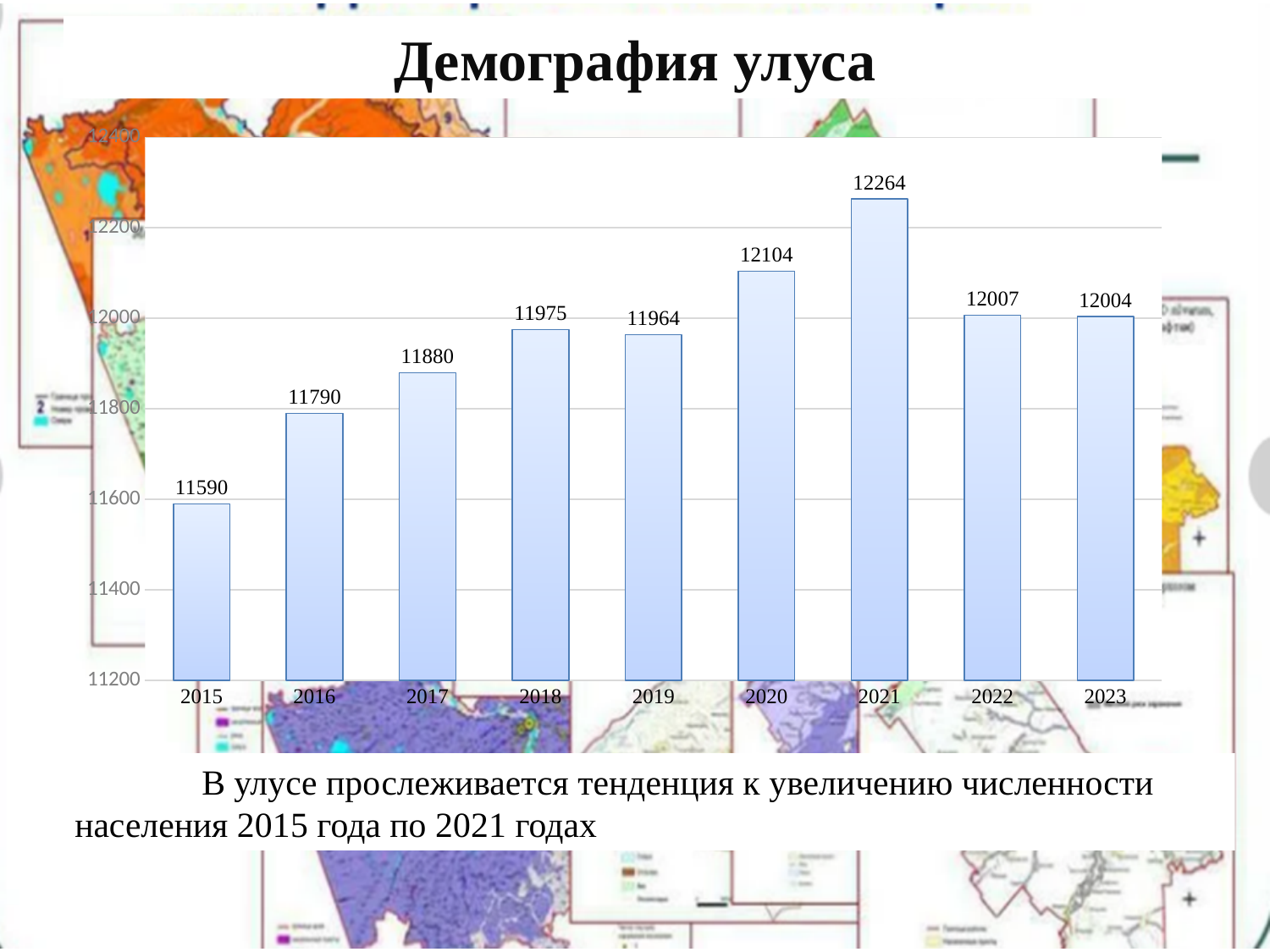
Which is larger, the value for 2018 or the value for 2019? 2018 What is the value for 2021? 12264 What is the difference between the values for 2020 and 2019? 140 Do the values rise or fall from 2015 to 2021? rise Which year has the lowest value? 2015 How many years are shown on the x axis? 9 What is the difference between the values for 2021 and 2015? 674 Which year has the highest value? 2021 What is the value for 2019? 11964 Is the value for 2017 greater or less than 12000? less What kind of chart is shown on the slide? bar chart What is the value for 2015? 11590